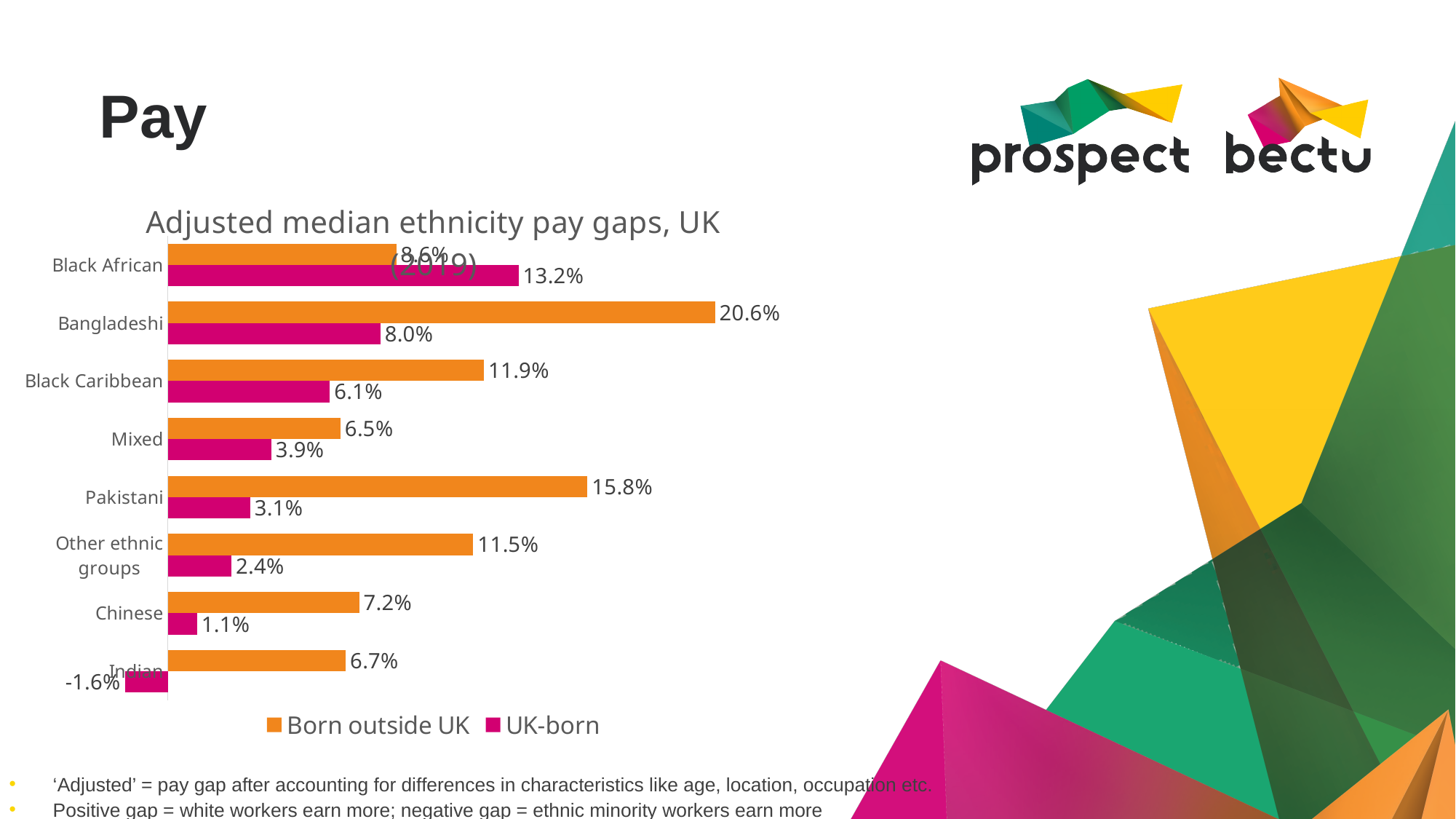
How many ethnic groups are shown on the chart? 8 What kind of chart is shown on the slide? Bar chart Which is larger for Chinese workers: the Born outside UK pay gap or the UK-born pay gap? Born outside UK Which colour represents the UK-born series? Magenta (pink) Which ethnic group has the highest Born outside UK pay gap? Bangladeshi What is the Born outside UK pay gap for Bangladeshi workers? 20.6% Which ethnic group has the lowest UK-born pay gap? Indian What is the difference between the Born outside UK and UK-born pay gaps for Pakistani workers? 12.7% How many series does the chart legend list? 2 What is the title of the chart? Adjusted median ethnicity pay gaps, UK (2019) What is the UK-born pay gap for Black African workers? 13.2% What is the UK-born pay gap for Indian workers? -1.6%